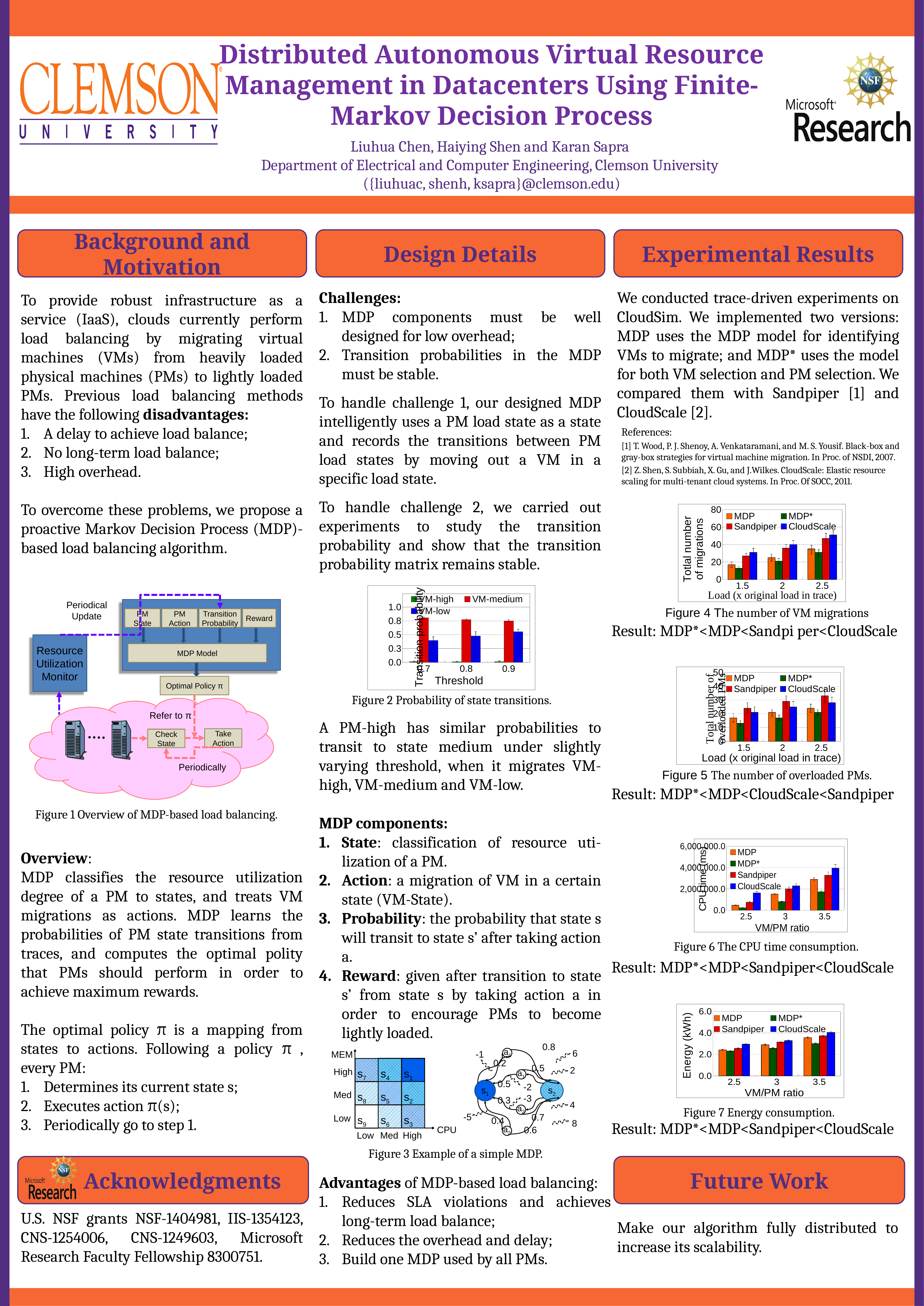
In Figure 6 (The CPU time consumption), is the value for CloudScale at VM/PM ratio 3.5 greater or less than 2,000,000.0? greater In Figure 4 (The number of VM migrations), which series has the highest value at load 2.5? CloudScale In Figure 7 (Energy consumption), what is the label of the x axis? VM/PM ratio In Figure 4 (The number of VM migrations), how many series does the legend list? 4 In Figure 4 (The number of VM migrations), is the value for MDP* at load 1.5 greater or less than 20? less In Figure 7 (Energy consumption), is the value for MDP* at VM/PM ratio 2.5 greater or less than 4.0? less In Figure 4 (The number of VM migrations), does the CloudScale series rise or fall as the load increases from 1.5 to 2.5? rise In Figure 4 (The number of VM migrations), what kind of chart is shown? bar chart In Figure 6 (The CPU time consumption), which series has the lowest value at VM/PM ratio 3.5? MDP* In Figure 5 (The number of overloaded PMs), how many load categories are shown on the x axis? 3 In Figure 5 (The number of overloaded PMs), which series has the highest value at load 2.5? Sandpiper In Figure 2 (Probability of state transitions), which series has the highest value at threshold 0.7? VM-medium